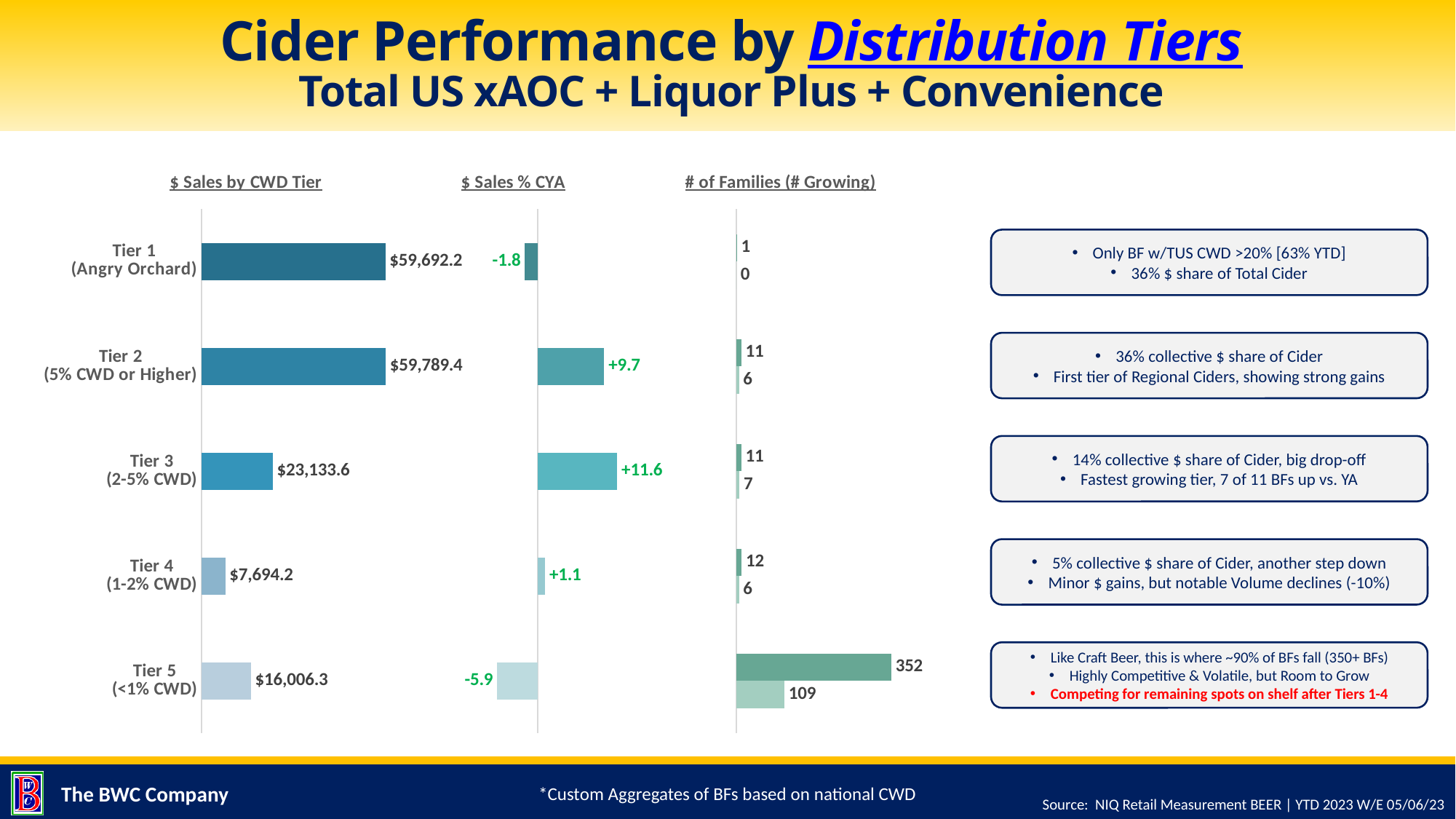
In the "$ Sales % CYA" chart, which tier has the highest value? Tier 3 (2-5% CWD) In the "$ Sales by CWD Tier" chart, what is the difference between Tier 5 (<1% CWD) and Tier 4 (1-2% CWD)? $8,312.1 What is the title of the leftmost chart on the slide? $ Sales by CWD Tier In the "# of Families (# Growing)" chart, how many families are growing in Tier 3 (2-5% CWD)? 7 In the "# of Families (# Growing)" chart, how many families are in Tier 5 (<1% CWD)? 352 How many tiers are shown in the "$ Sales by CWD Tier" chart? 5 In the "$ Sales % CYA" chart, what is the value for Tier 2 (5% CWD or Higher)? +9.7 In the "$ Sales by CWD Tier" chart, what is the value for Tier 3 (2-5% CWD)? $23,133.6 In the "# of Families (# Growing)" chart, how many more total families than growing families are in Tier 5 (<1% CWD)? 243 In the "$ Sales by CWD Tier" chart, which tier has the lowest sales? Tier 4 (1-2% CWD) In the "$ Sales % CYA" chart, which is larger: Tier 2 (5% CWD or Higher) or Tier 3 (2-5% CWD)? Tier 3 (2-5% CWD) What kind of chart is the "$ Sales % CYA" chart? Bar chart